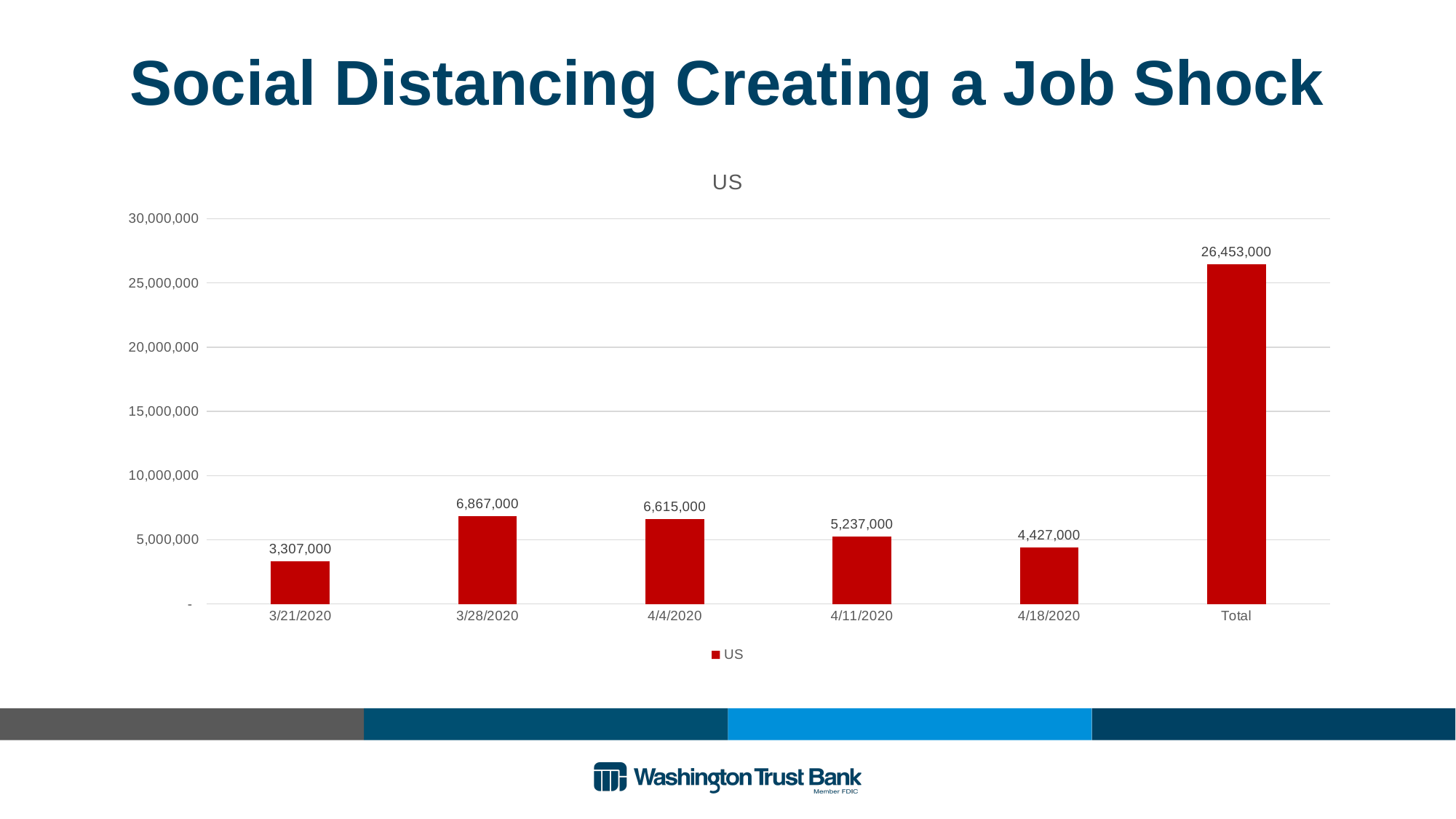
What kind of chart is shown on the slide? bar chart Is the value for 4/18/2020 greater or less than 5,000,000? less How many bars are shown in the chart? 6 What is the value for the Total bar? 26,453,000 What is the value for 3/21/2020? 3,307,000 What is the title of the chart? US How many series does the legend list? 1 Which weekly date has the highest value? 3/28/2020 Which category has the lowest value? 3/21/2020 Which is larger, the value for 4/11/2020 or the value for 4/18/2020? 4/11/2020 What is the value for 4/11/2020? 5,237,000 What is the difference between the values for 3/28/2020 and 4/4/2020? 252,000